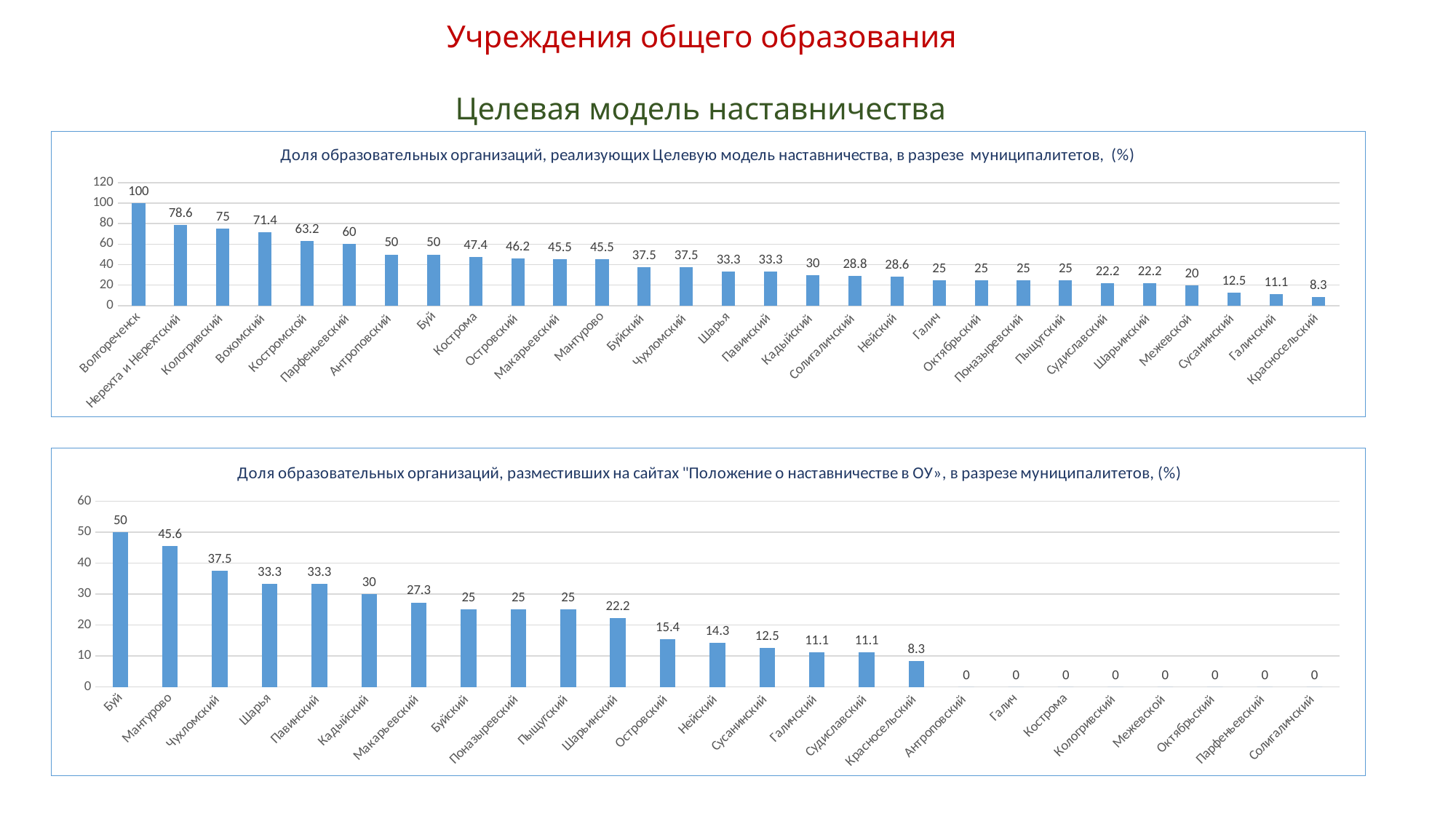
In the bottom chart, which municipality has the highest value? Буй In the top chart, which is larger, the value for Кострома or the value for Островский? Кострома In the bottom chart, how many municipalities have a value of 0? 8 In the bottom chart, what is the value for Мантурово? 45.6 In the top chart, which municipality has the lowest value? Красносельский What type of chart is the bottom chart? Bar chart In the top chart, what is the value for Костромской? 63.2 How many municipalities are shown in the top chart? 29 In the bottom chart, do the values rise or fall from left to right along the x axis? Fall In the top chart, what is the difference between the values for Нерехта и Нерехтский and Кологривский? 3.6 In the top chart, what is the value for Волгореченск? 100 In the bottom chart, what is the difference between the values for Буй and Чухломский? 12.5